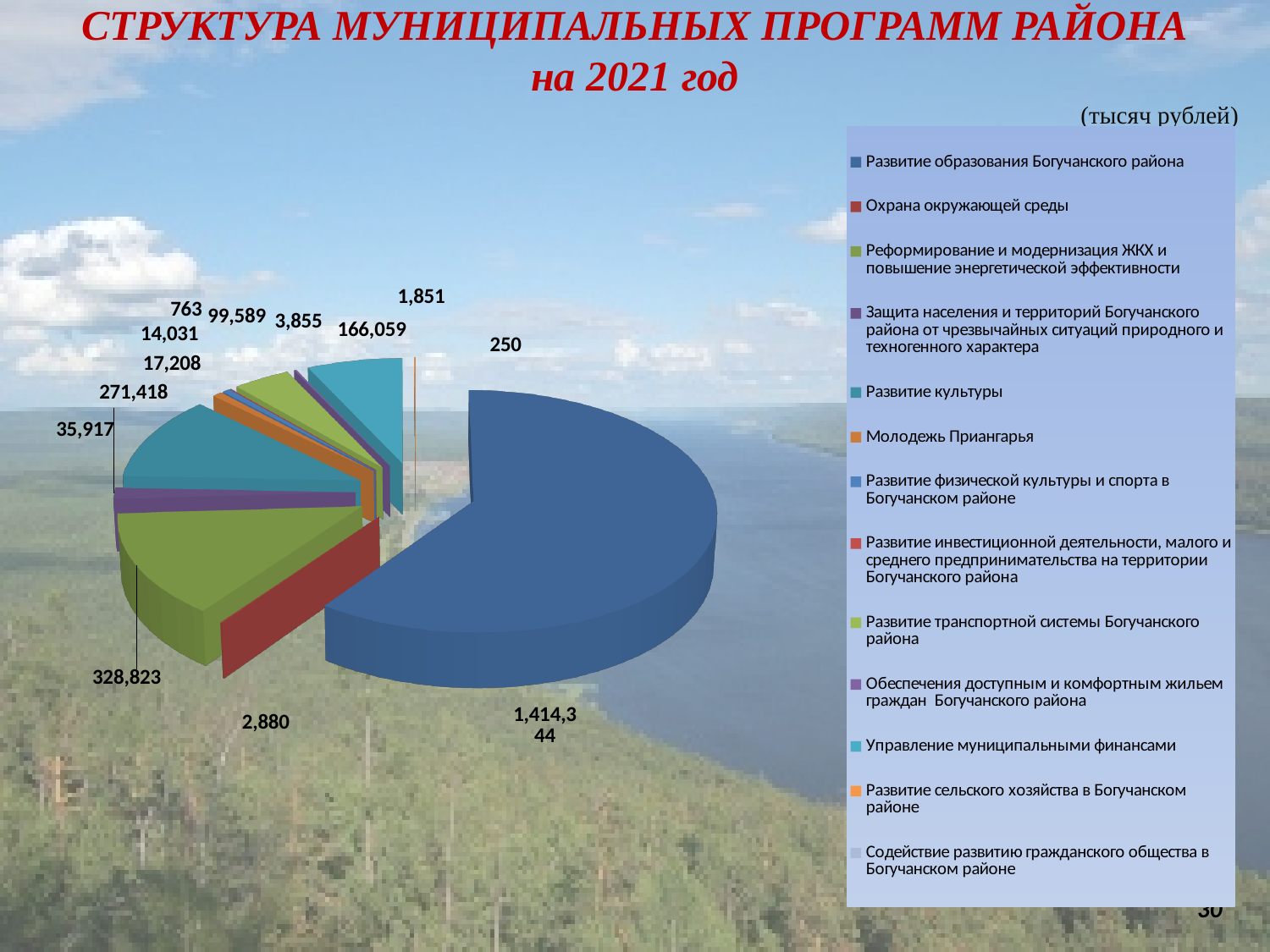
How many entries does the chart legend list? 13 What is the value for Управление муниципальными финансами? 166,059 Which is larger: the value for Развитие культуры or the value for Управление муниципальными финансами? Развитие культуры What kind of chart is shown on the slide? pie chart What is the difference between the value for Реформирование и модернизация ЖКХ and the value for Развитие культуры? 57,405 What is the value for Развитие образования Богучанского района? 1,414,344 What is the value for Развитие транспортной системы Богучанского района? 99,589 What is the smallest value shown on the pie chart? 250 Which program has the largest share of the pie? Развитие образования Богучанского района In what units are the values on the chart given, according to the slide? тысяч рублей What is the value for Реформирование и модернизация ЖКХ и повышение энергетической эффективности? 328,823 What is the value for Развитие культуры? 271,418